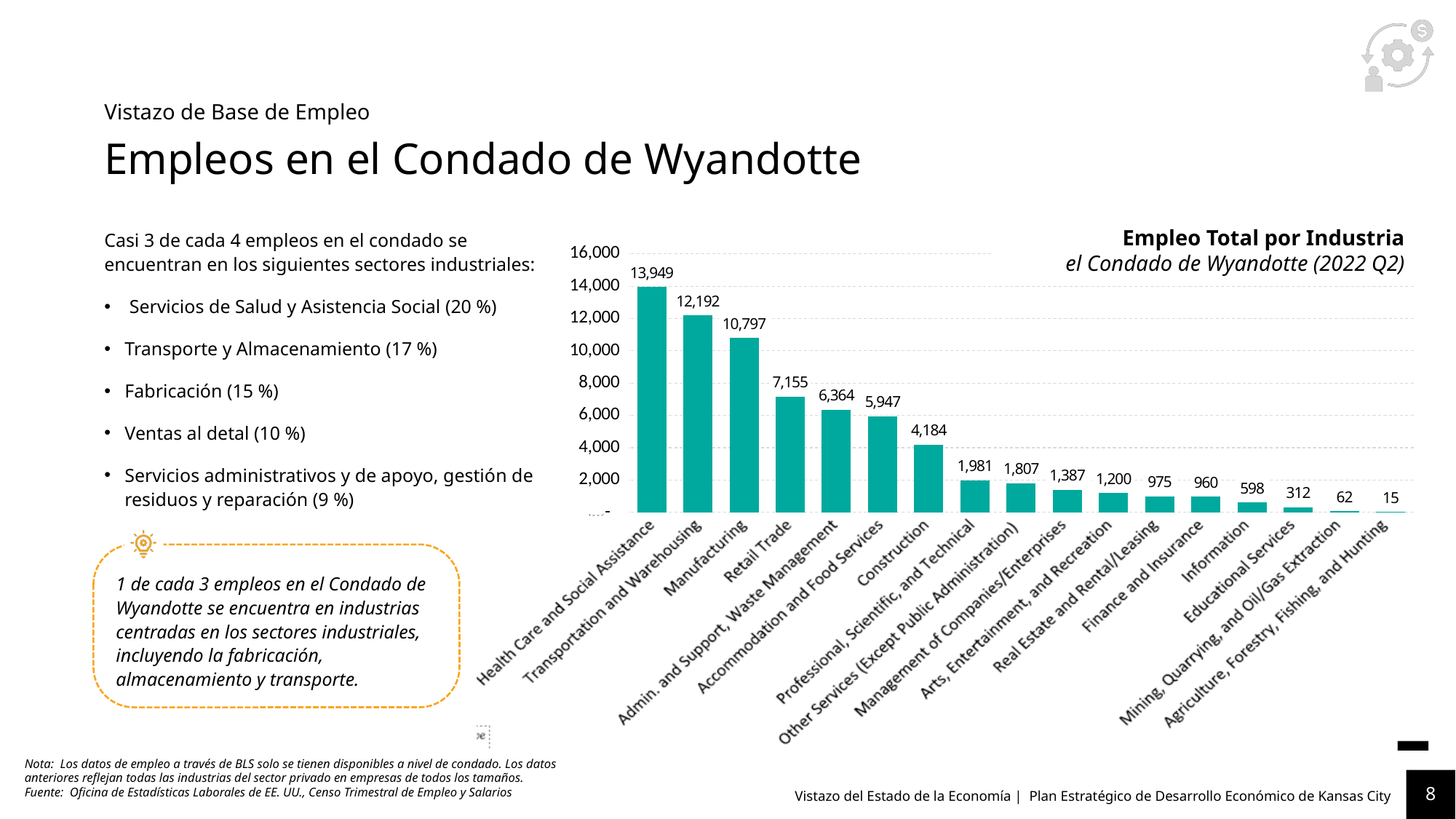
Which industry has the highest employment? Health Care and Social Assistance Is the value for Admin. and Support, Waste Management greater or less than 6,000? greater Which industry has the lowest employment? Agriculture, Forestry, Fishing, and Hunting What is the title of the chart? Empleo Total por Industria el Condado de Wyandotte (2022 Q2) What is the difference between Transportation and Warehousing and Manufacturing? 1,395 What is the value for Construction? 4,184 What kind of chart is shown? bar chart Which is larger, Retail Trade or Accommodation and Food Services? Retail Trade What is the value for Information? 598 How many industries are shown in the chart? 17 What is the value for Health Care and Social Assistance? 13,949 What is the value for Manufacturing? 10,797